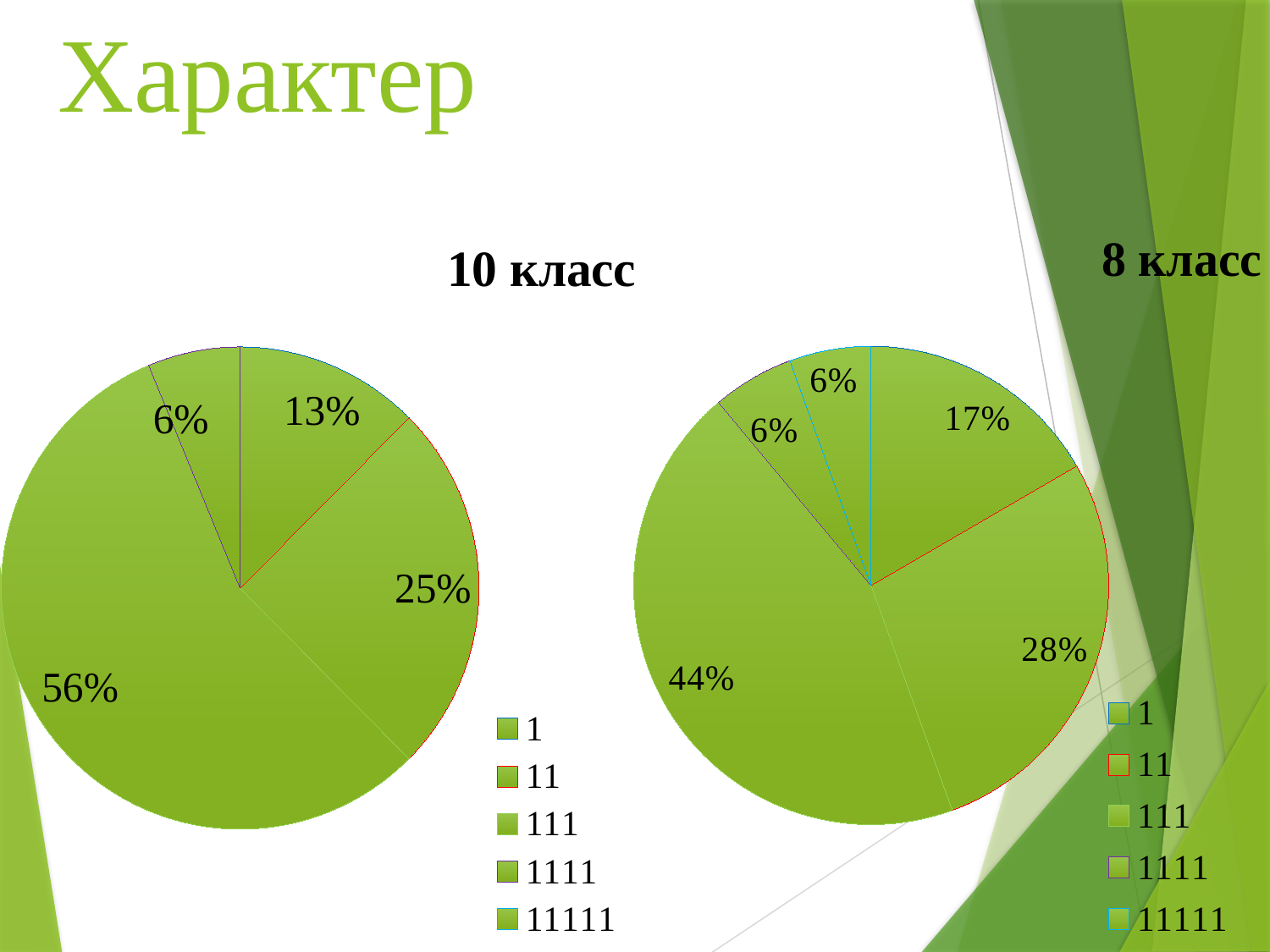
What are the legend entries of the "8 класс" chart? 1, 11, 111, 1111, 11111 How many entries does the legend of the "10 класс" chart list? 5 What is the title of the pie chart on the left of the slide? 10 класс Which is larger: the largest slice of the "10 класс" chart (56%) or the largest slice of the "8 класс" chart (44%)? 10 класс (56%) In the "10 класс" pie chart, what is the smallest labelled slice's share? 6% What is the difference between the largest slice of the "10 класс" chart and the largest slice of the "8 класс" chart? 12 percentage points How many percentage labels are shown on the "10 класс" pie chart? 4 What kind of chart is the "10 класс" chart? Pie chart In the "10 класс" pie chart, what is the largest labelled slice's share? 56% How many percentage labels are shown on the "8 класс" pie chart? 5 In the "8 класс" pie chart, what is the difference between the 28% slice and the 17% slice? 11 percentage points In the "8 класс" pie chart, what is the largest labelled slice's share? 44%